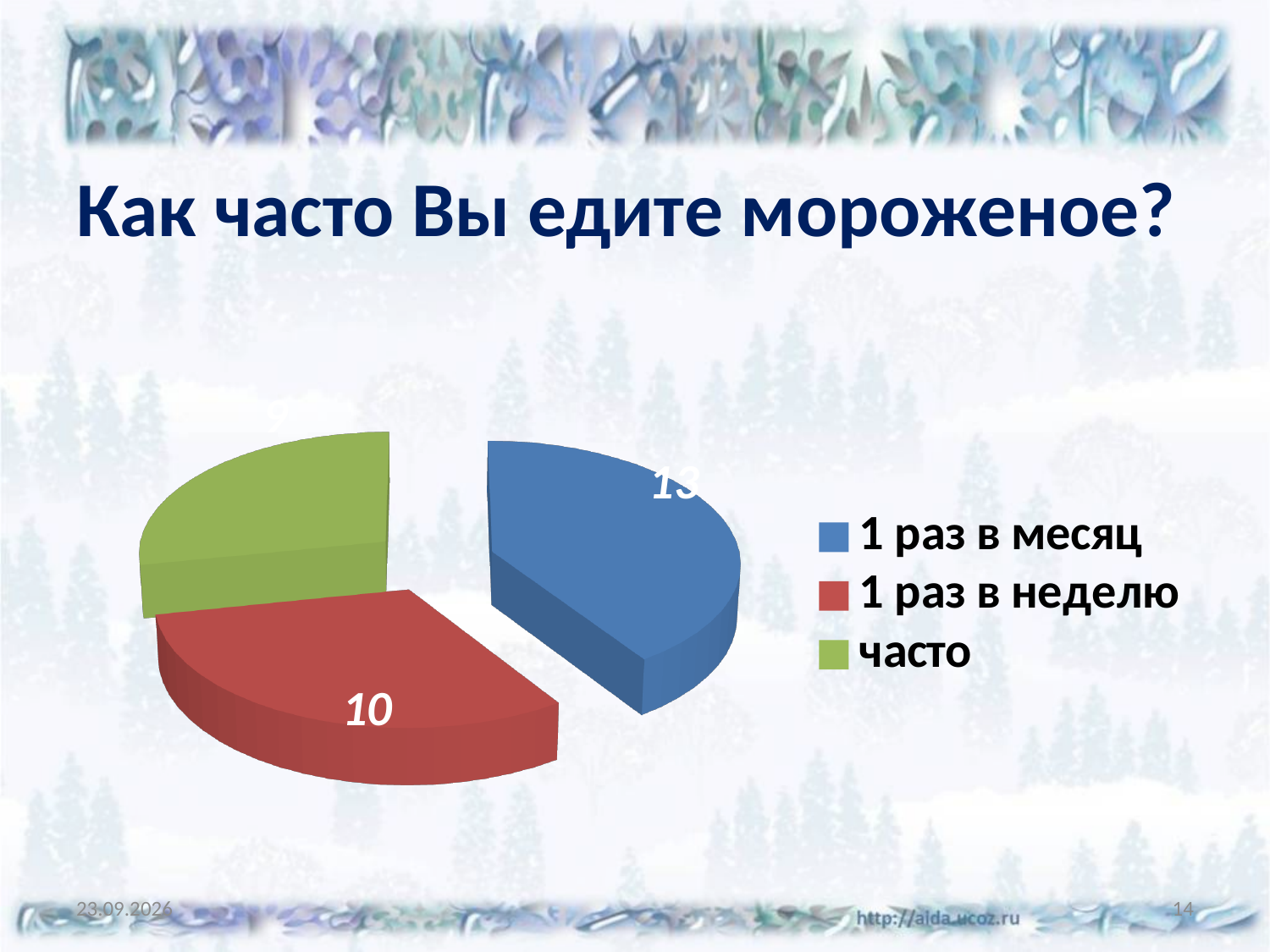
What is the value for "часто"? 9 What is the difference between the values for "1 раз в месяц" and "1 раз в неделю"? 3 Which is larger, the value for "1 раз в месяц" or the value for "часто"? 1 раз в месяц What is the value for "1 раз в месяц"? 13 Which category has the smallest slice? часто What is the title of the chart on the slide? Как часто Вы едите мороженое? What is the value for "1 раз в неделю"? 10 What is the total of all the values shown in the pie chart? 32 What kind of chart is shown on the slide? pie chart What is the difference between the values for "1 раз в месяц" and "часто"? 4 How many slices does the pie chart have? 3 Which category has the largest slice? 1 раз в месяц